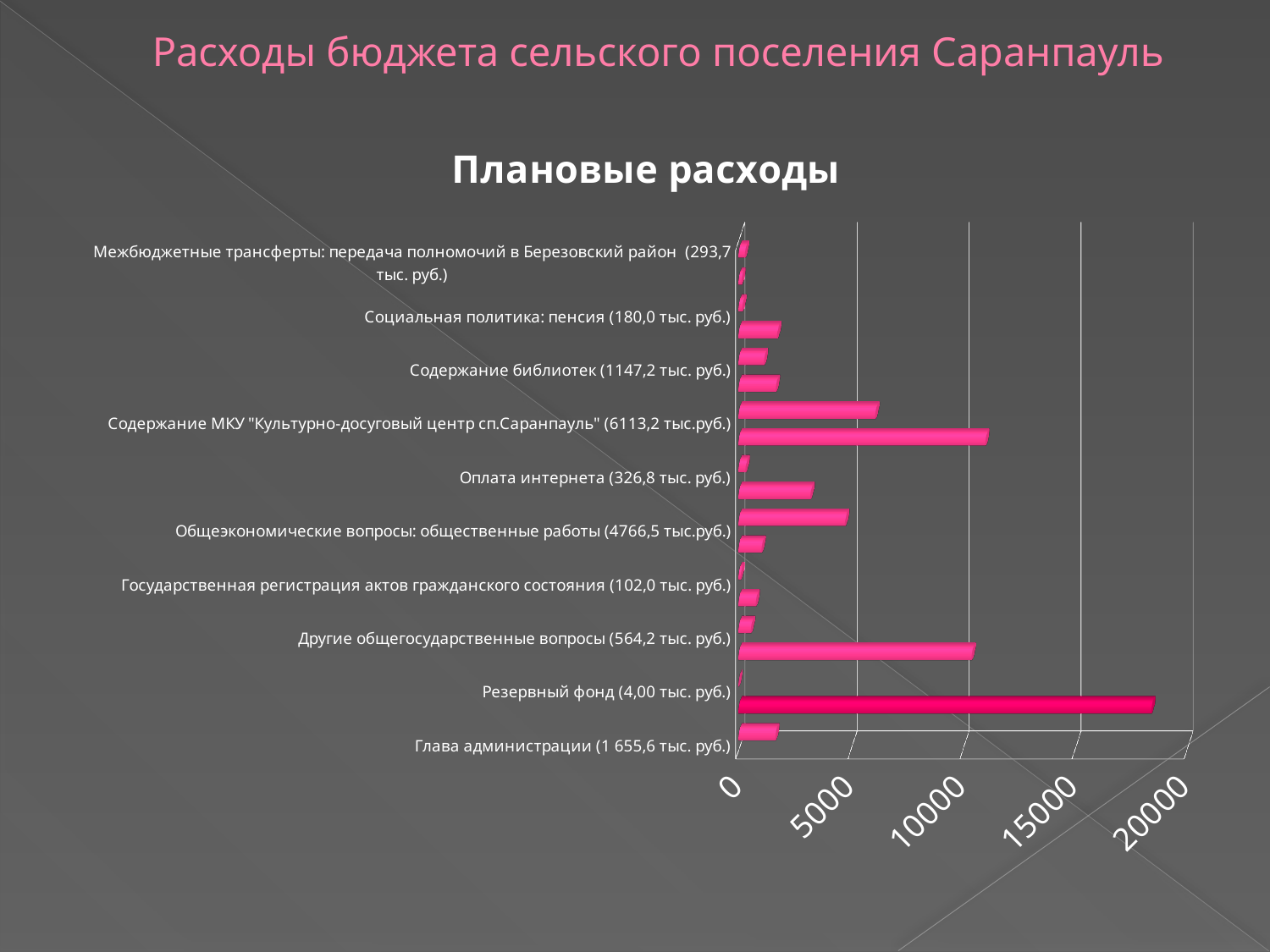
What is the difference between the value for "Содержание МКУ "Культурно-досуговый центр сп.Саранпауль"" (6113,2) and the value for "Содержание библиотек" (1147,2)? 4966,0 тыс. руб. What value is printed in the label for "Резервный фонд"? 4,00 тыс. руб. What value is printed in the label for "Социальная политика: пенсия"? 180,0 тыс. руб. Which is larger: the value for "Содержание МКУ "Культурно-досуговый центр сп.Саранпауль"" or the value for "Содержание библиотек"? Содержание МКУ "Культурно-досуговый центр сп.Саранпауль" Is the value for "Общеэкономические вопросы: общественные работы" greater or less than 5000? less What value is printed in the label for "Оплата интернета"? 326,8 тыс. руб. What value is printed in the label for "Глава администрации"? 1 655,6 тыс. руб. What is the title of the chart? Плановые расходы What value is printed in the label for "Содержание МКУ "Культурно-досуговый центр сп.Саранпауль""? 6113,2 тыс.руб. Is the longest bar in the chart greater or less than 15000? greater What is the highest value shown on the horizontal axis of the chart? 20000 What kind of chart is shown under the title "Плановые расходы"? bar chart